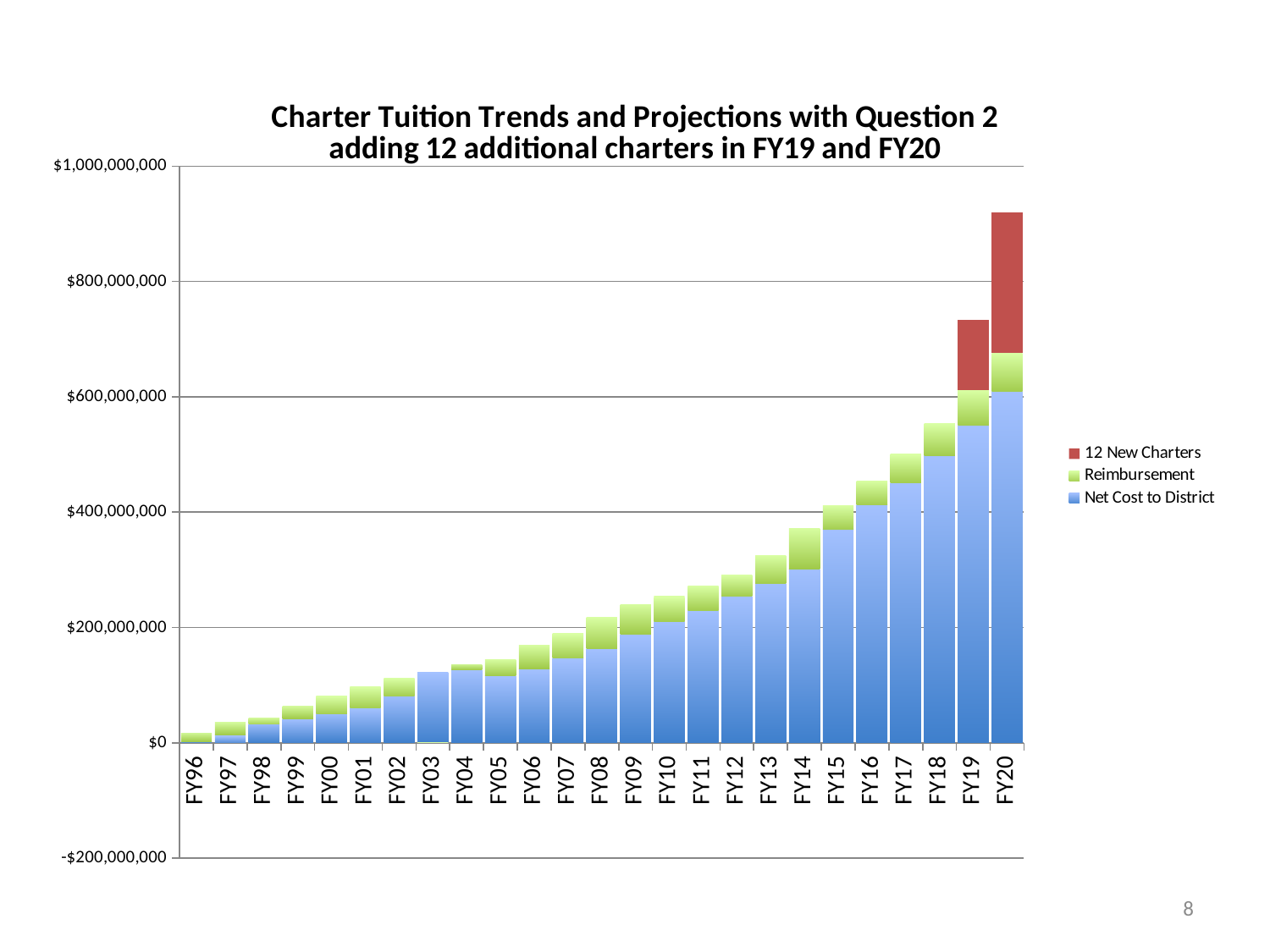
Which fiscal year has the tallest stacked bar? FY20 Is the total stacked bar for FY19 greater or less than $600,000,000? greater Is the Net Cost to District value for FY17 greater or less than $400,000,000? greater Which fiscal year has the shortest stacked bar? FY96 Which has the larger total stacked bar, FY19 or FY20? FY20 Which series in the legend is shown in red? 12 New Charters How many fiscal years are shown along the x axis? 25 Is the total stacked bar for FY14 greater or less than $400,000,000? less What kind of chart is shown on the slide? Stacked bar chart Do the stacked bar totals generally rise or fall from FY96 to FY20? Rise How many series does the legend list? 3